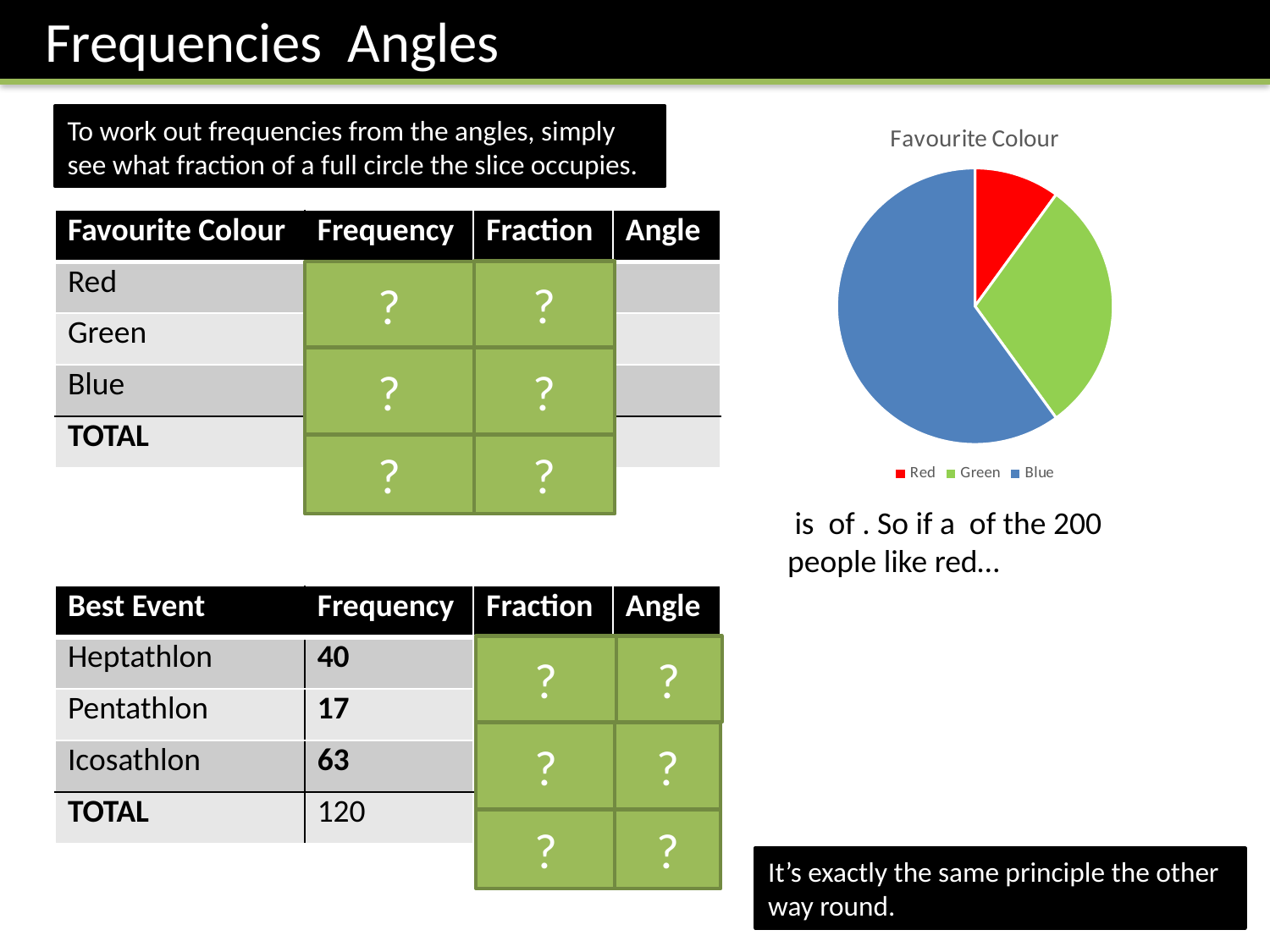
How many entries does the legend of the Favourite Colour pie chart list? 3 What are the legend entries of the Favourite Colour pie chart, in order? Red, Green, Blue What kind of chart is shown on the slide? pie chart Which colour has the smallest slice in the Favourite Colour pie chart? Red In the Favourite Colour pie chart, which slice is smaller, Red or Blue? Red Which colour has the largest slice in the Favourite Colour pie chart? Blue In the Favourite Colour pie chart, which slice is larger, Green or Red? Green How many slices does the Favourite Colour pie chart have? 3 In the Favourite Colour pie chart, which slice is larger, Blue or Green? Blue What is the title of the pie chart? Favourite Colour